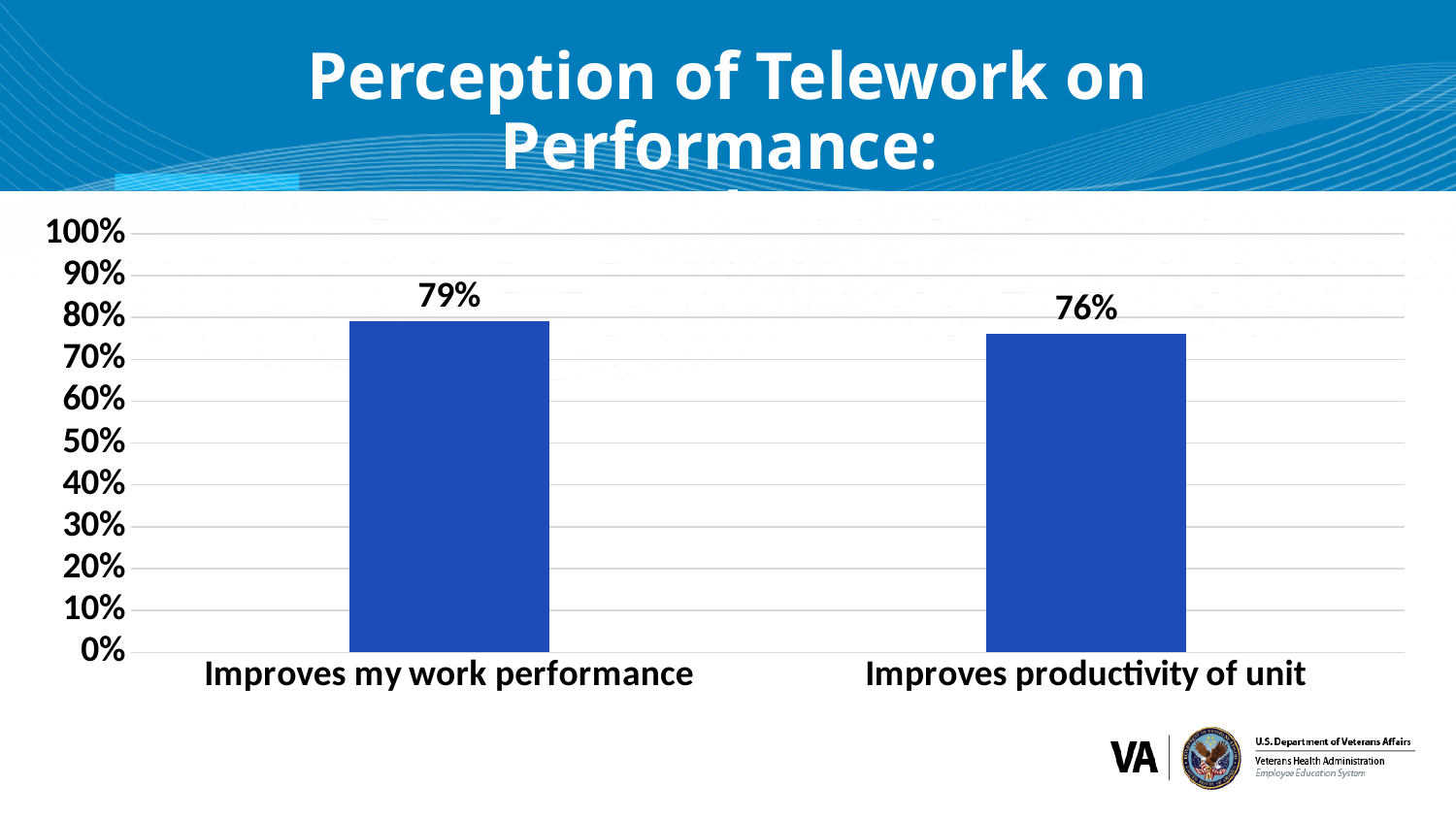
What is the maximum value shown on the vertical axis? 100% What is the value for "Improves productivity of unit"? 76% How many categories are shown in the chart? 2 Which category has the lowest value? Improves productivity of unit Is the value for "Improves my work performance" greater or less than 70%? greater What is the difference between the values for "Improves my work performance" and "Improves productivity of unit"? 3% Which category has the highest value? Improves my work performance What colour are the bars in the chart? Blue What is the value for "Improves my work performance"? 79% What kind of chart is shown on the slide? Bar chart Which is larger: the value for "Improves my work performance" or the value for "Improves productivity of unit"? Improves my work performance Is the value for "Improves productivity of unit" greater or less than 80%? less